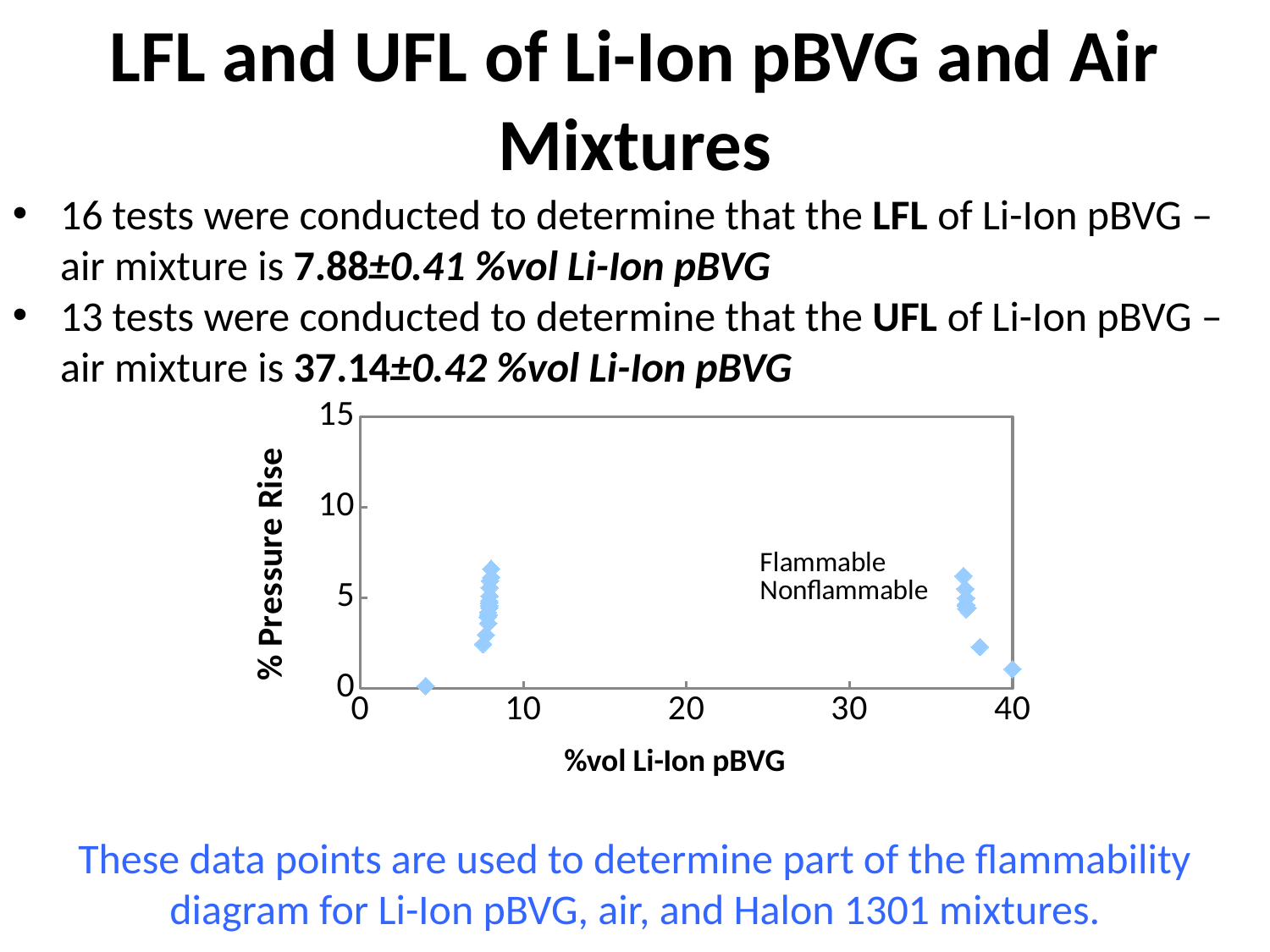
What kind of chart is shown on the slide? scatter chart How many data points lie between 10 and 30 %vol Li-Ion pBVG on the chart? 0 Is the highest point in the cluster near 8 %vol Li-Ion pBVG greater or less than 5 % Pressure Rise? greater What is the highest value shown on the y axis of the chart? 15 Is the %vol Li-Ion pBVG of the point with the lowest % Pressure Rise greater or less than 10? less Is the % Pressure Rise of the point at about 40 %vol Li-Ion pBVG greater or less than 5? less What is the highest value shown on the x axis of the chart? 40 What is the label of the x axis of the chart? %vol Li-Ion pBVG What is the label of the y axis of the chart? % Pressure Rise